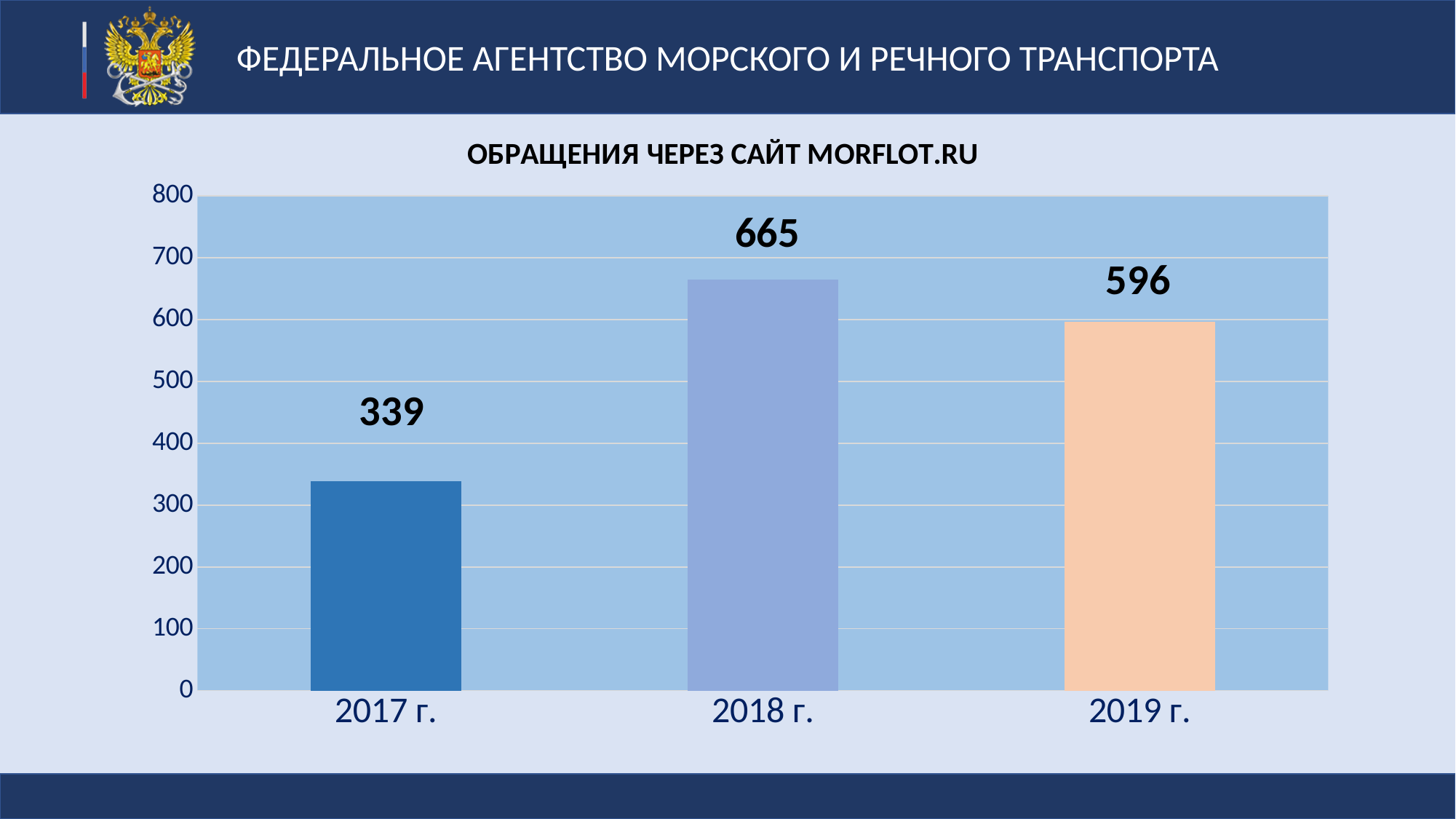
What is the title of the chart? ОБРАЩЕНИЯ ЧЕРЕЗ САЙТ MORFLOT.RU Which year has the highest value? 2018 г. Is the value for 2019 г. greater or less than 500? greater Which year has the lowest value? 2017 г. What is the difference between the values for 2018 г. and 2019 г.? 69 What is the value for 2017 г.? 339 Which is larger, the value for 2019 г. or the value for 2017 г.? 2019 г. What is the difference between the values for 2018 г. and 2017 г.? 326 What kind of chart is shown on the slide? Bar chart What is the value for 2019 г.? 596 What is the value for 2018 г.? 665 How many years are shown on the chart? 3